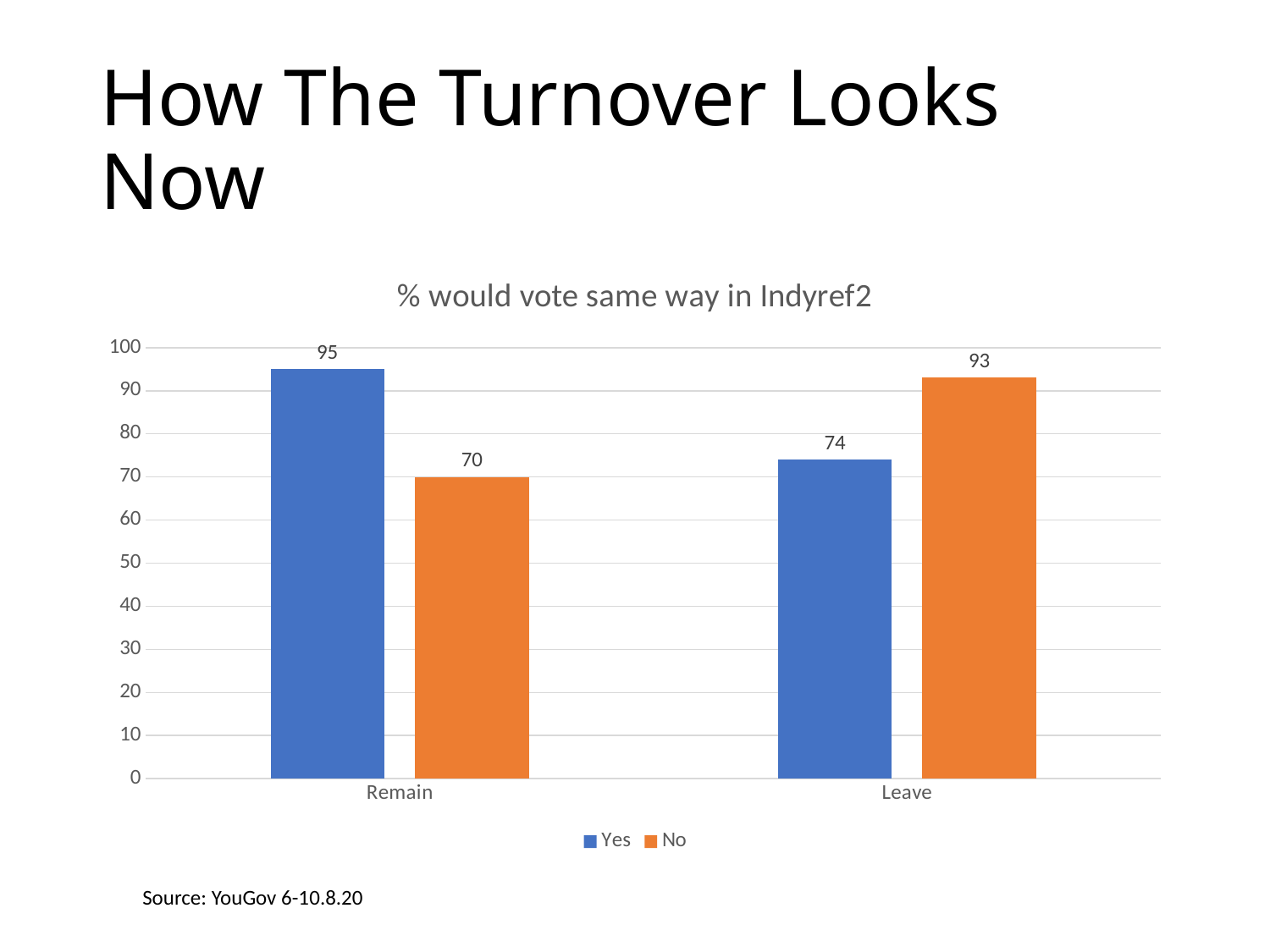
What is the value for Yes in the Remain category? 95 How many categories are shown on the x axis? 2 How many series does the legend list? 2 What is the value for No in the Leave category? 93 What is the difference between the Yes and No values in the Remain category? 25 What is the value for Yes in the Leave category? 74 Which category has the highest value for the Yes series? Remain What kind of chart is shown on the slide? Bar chart What is the value for No in the Remain category? 70 In the Leave category, which is larger, Yes or No? No What is the difference between the No and Yes values in the Leave category? 19 Which category has the lowest value for the No series? Remain